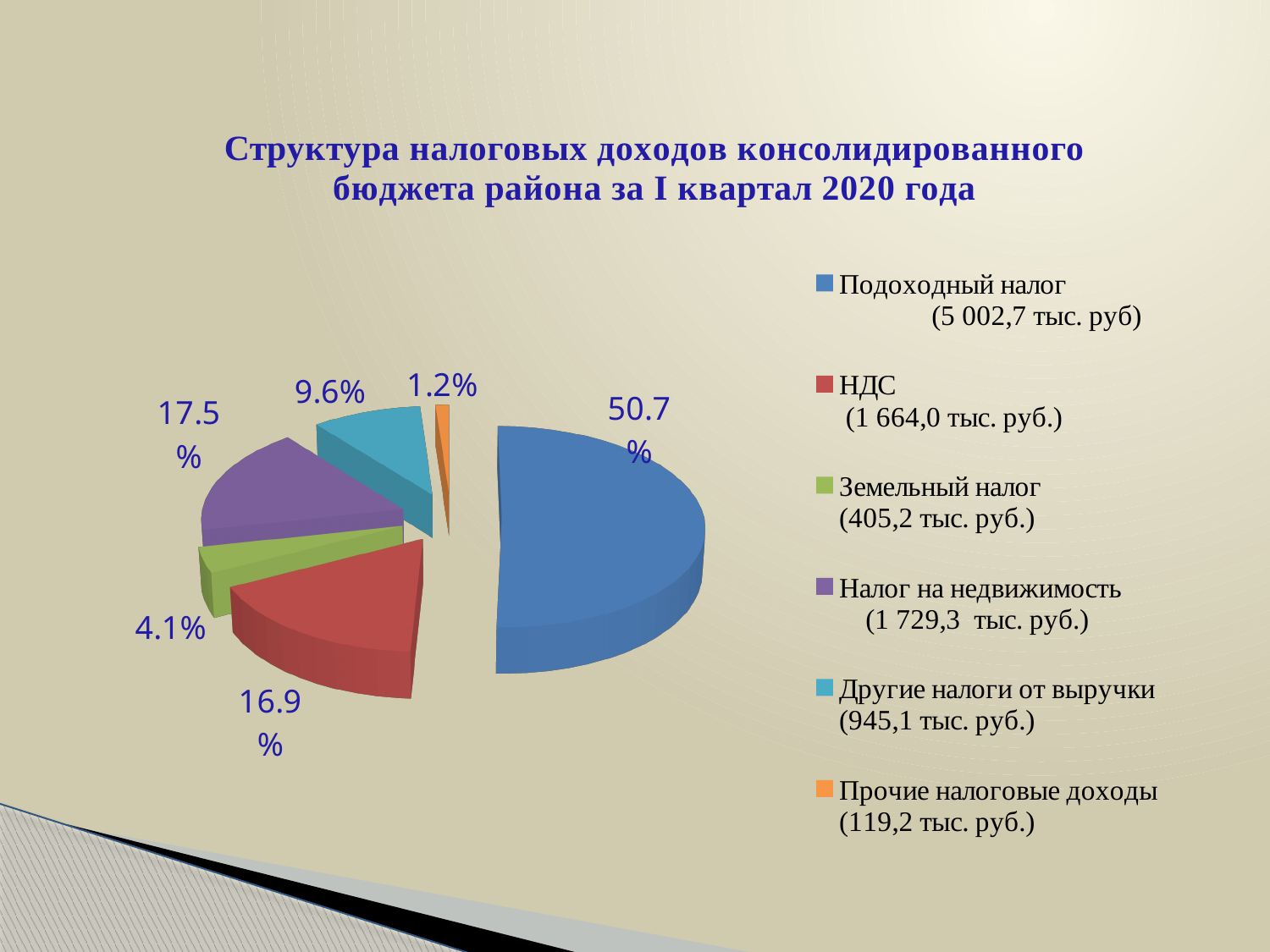
Which is larger: the share for Другие налоги от выручки or the share for Земельный налог? Другие налоги от выручки Which category has the smallest slice of the pie? Прочие налоговые доходы What share of the pie does Прочие налоговые доходы have? 1.2% According to the legend, what amount in тыс. руб. corresponds to НДС? 1 664,0 тыс. руб. What is the difference in percentage points between the share for Налог на недвижимость and the share for НДС? 0.6 What share of the pie does Подоходный налог have? 50.7% What share of the pie does Земельный налог have? 4.1% What kind of chart is shown on the slide? pie chart How many slices does the pie chart have? 6 Which category has the largest slice of the pie? Подоходный налог